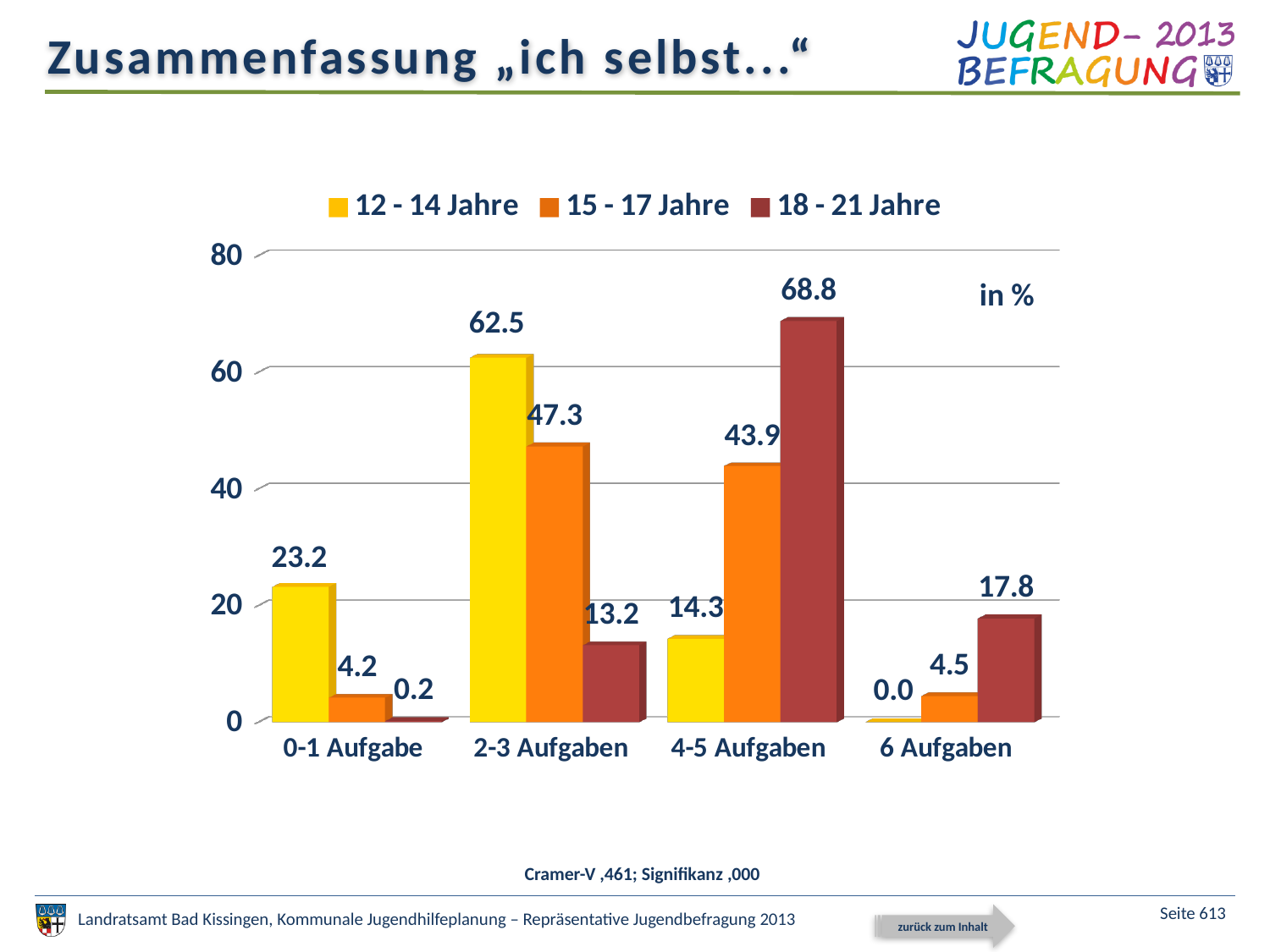
How many series does the legend list? 3 What is the value for 18 - 21 Jahre in the 4-5 Aufgaben category? 68.8 What is the difference between the 12 - 14 Jahre and 15 - 17 Jahre values in the 2-3 Aufgaben category? 15.2 What is the value for 15 - 17 Jahre in the 0-1 Aufgabe category? 4.2 Which category has the highest value for the 18 - 21 Jahre series? 4-5 Aufgaben In the 4-5 Aufgaben category, which series has the larger value: 15 - 17 Jahre or 12 - 14 Jahre? 15 - 17 Jahre What is the value for 12 - 14 Jahre in the 6 Aufgaben category? 0.0 How many categories are shown on the x axis? 4 Which category has the lowest value for the 12 - 14 Jahre series? 6 Aufgaben What is the value for 12 - 14 Jahre in the 2-3 Aufgaben category? 62.5 What unit is indicated for the values in the chart? in % What kind of chart is shown on the slide? bar chart